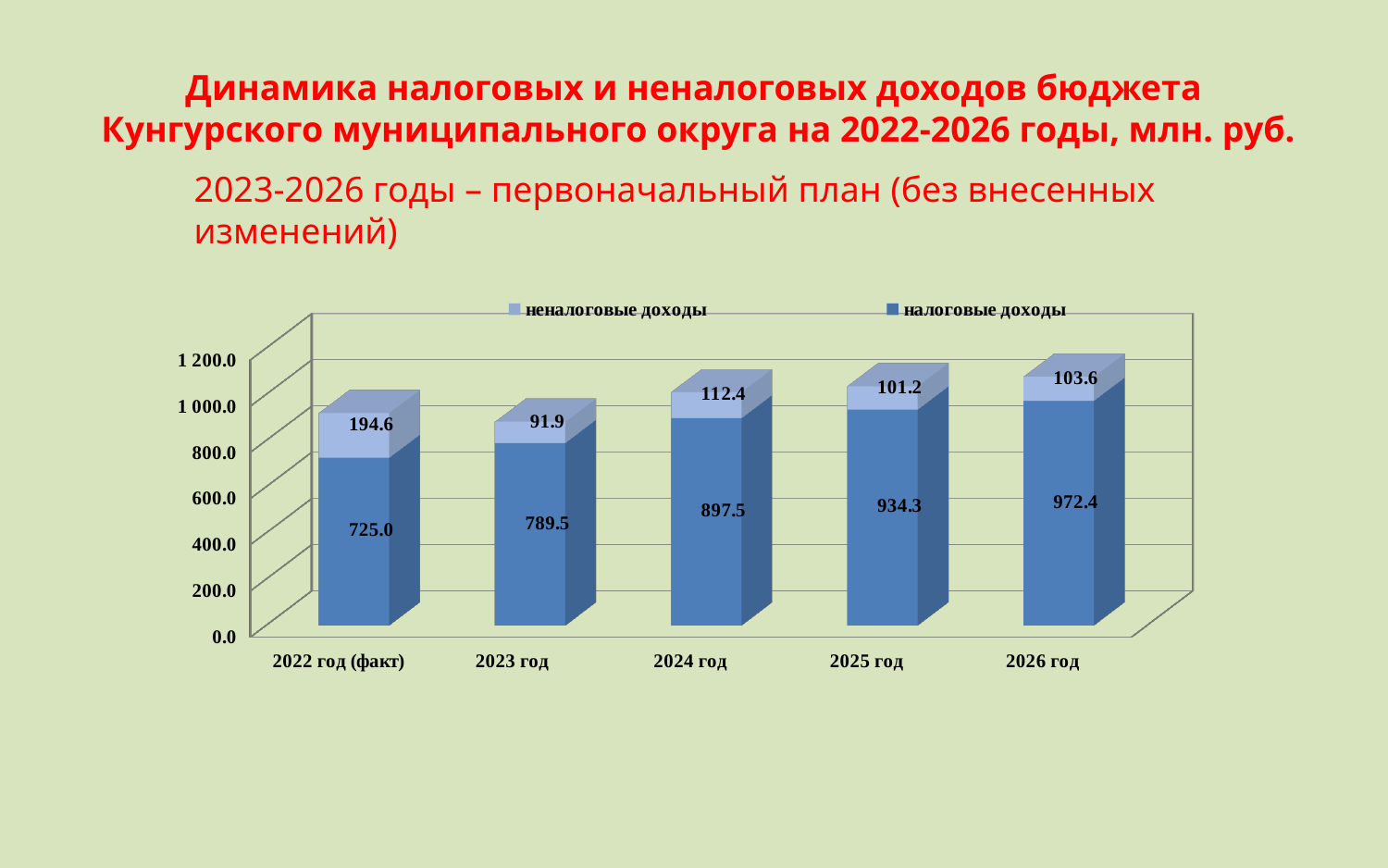
Do the values of налоговые доходы rise or fall from 2022 год (факт) to 2026 год? rise How many years are shown on the x axis? 5 Which year has the lowest value of неналоговые доходы? 2023 год What is the value of налоговые доходы for 2026 год? 972.4 How many series does the legend list? 2 What is the difference between налоговые доходы in 2026 год and 2022 год (факт)? 247.4 Which year has the highest value of налоговые доходы? 2026 год Which is larger: неналоговые доходы in 2024 год or in 2025 год? 2024 год What is the value of неналоговые доходы for 2022 год (факт)? 194.6 What is the value of налоговые доходы for 2024 год? 897.5 What is the total of the stacked bar for 2023 год? 881.4 What is the total of the stacked bar for 2025 год? 1035.5